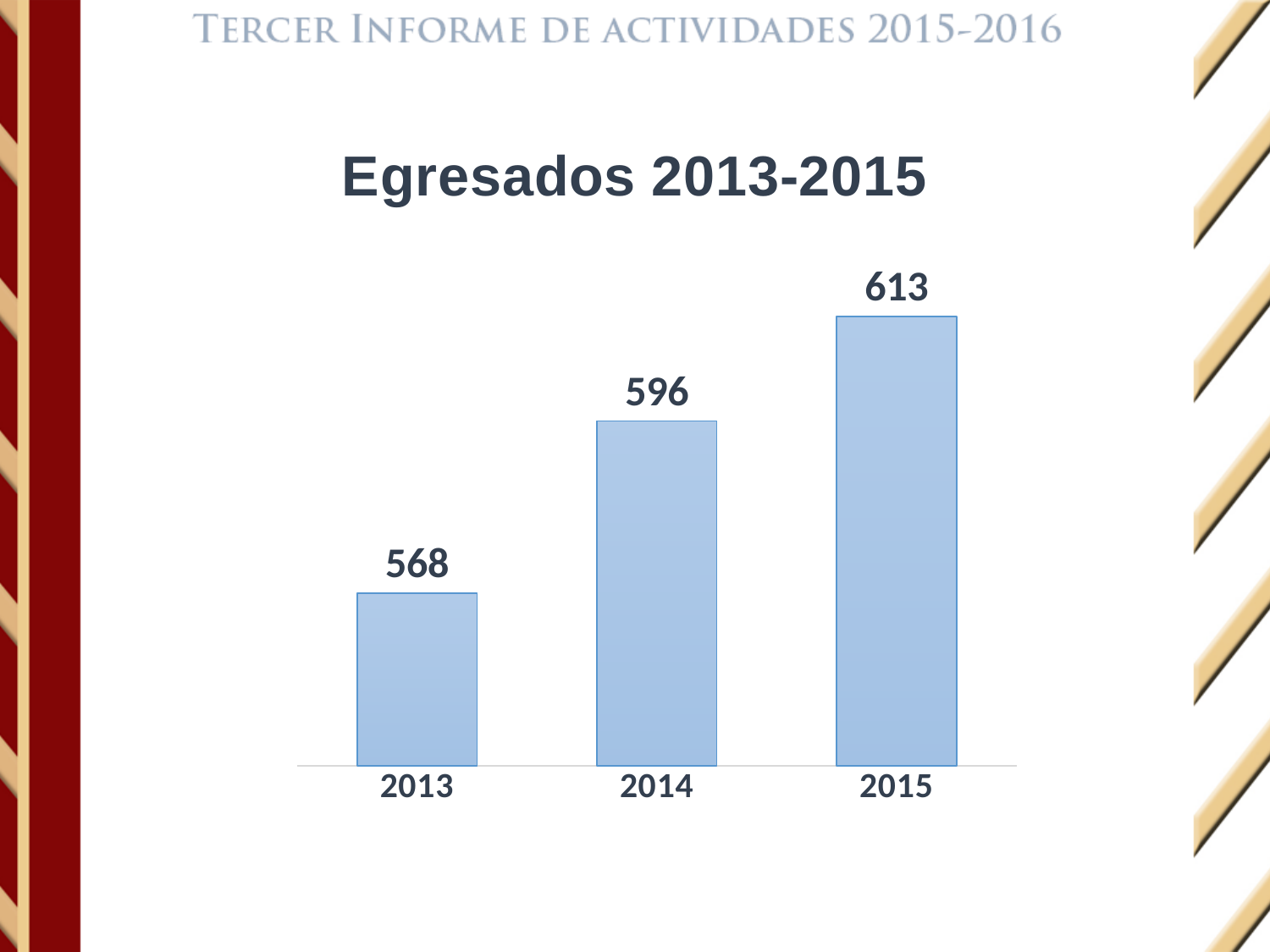
Which year has the lowest value? 2013 Which year has the highest value? 2015 What is the value for 2014? 596 What kind of chart is shown on the slide? bar chart How many years are shown on the chart? 3 What is the title of the chart? Egresados 2013-2015 What is the difference between the values for 2015 and 2013? 45 What is the value for 2013? 568 What is the value for 2015? 613 Which is larger, the value for 2014 or the value for 2015? 2015 Do the values rise or fall from 2013 to 2015? rise What is the difference between the values for 2014 and 2013? 28